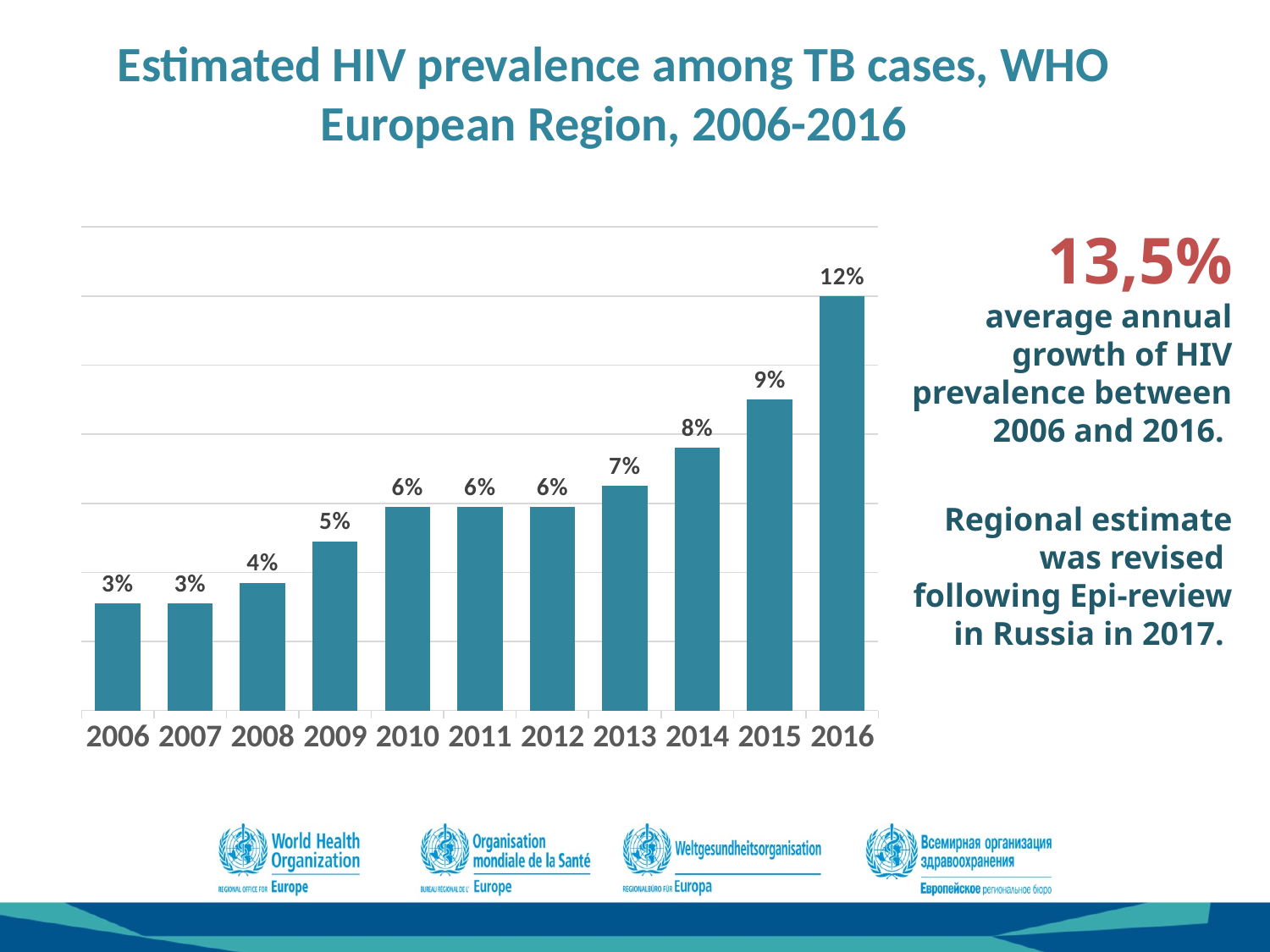
What is the difference in HIV prevalence between 2015 and 2014? 1 percentage point What is the difference in HIV prevalence between 2016 and 2006? 9 percentage points How many years are shown on the x axis of the chart? 11 What is the estimated HIV prevalence among TB cases in 2016? 12% What is the estimated HIV prevalence among TB cases in 2013? 7% What is the estimated HIV prevalence among TB cases in 2009? 5% Do the values generally rise or fall from 2006 to 2016? Rise What is the title of the chart? Estimated HIV prevalence among TB cases, WHO European Region, 2006-2016 What average annual growth of HIV prevalence between 2006 and 2016 is stated next to the chart? 13,5% Which year has the highest estimated HIV prevalence among TB cases? 2016 What kind of chart is shown on the slide? Bar chart Which year has the higher HIV prevalence, 2008 or 2015? 2015